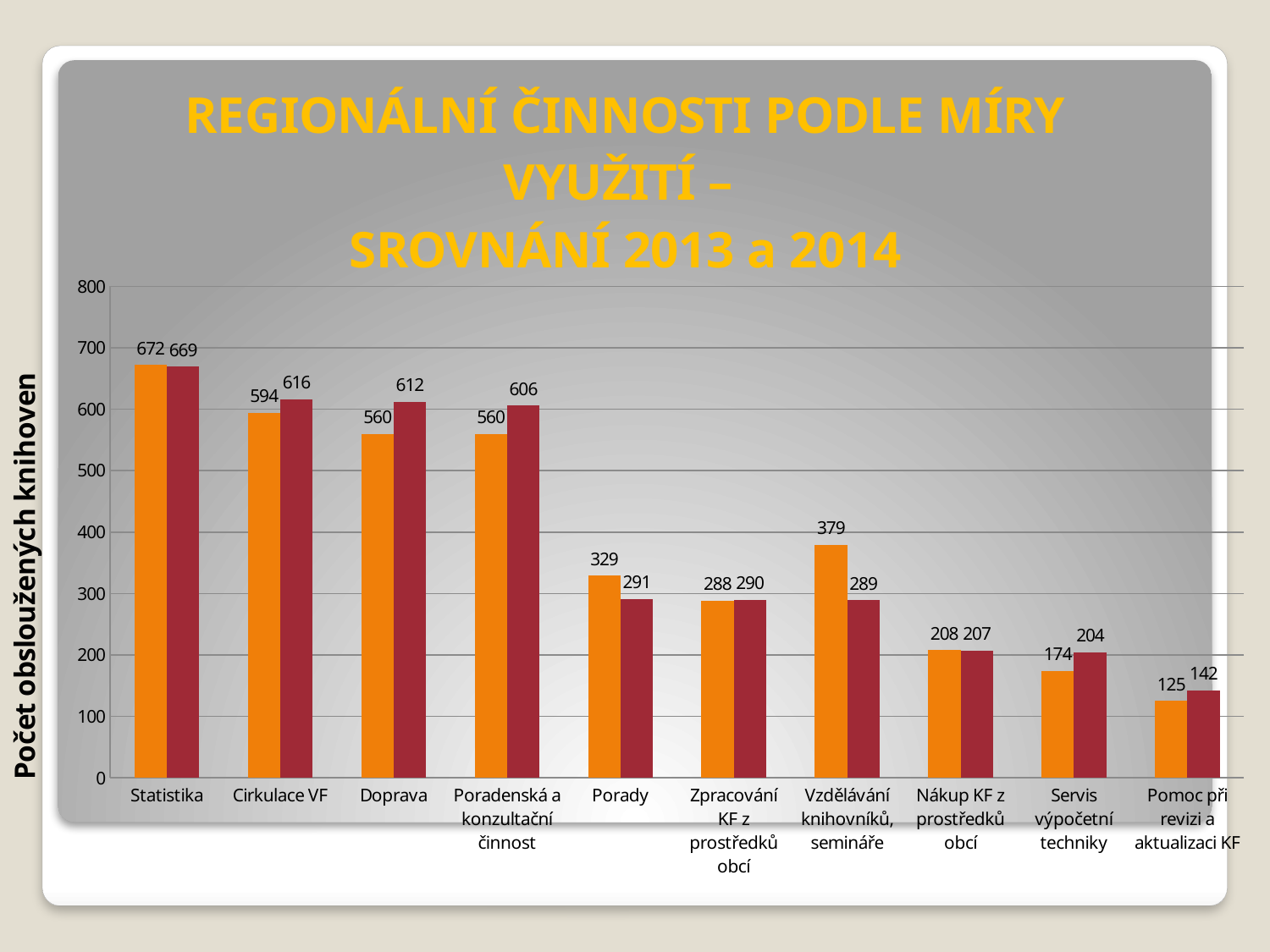
What is the value of the dark red bar for Doprava? 612 What is the difference between the orange and dark red bars for Vzdělávání knihovníků, semináře? 90 What type of chart is shown on the slide? bar chart What is the value of the orange bar for Statistika? 672 What is the value of the dark red bar for Pomoc při revizi a aktualizaci KF? 142 Which category has the lowest dark red bar? Pomoc při revizi a aktualizaci KF What is the value of the orange bar for Vzdělávání knihovníků, semináře? 379 How many categories are shown on the x axis of the chart? 10 For Servis výpočetní techniky, which bar is larger, the orange or the dark red one? dark red What is the difference between the orange bars for Porady and Nákup KF z prostředků obcí? 121 What is the label of the vertical axis? Počet obsloužených knihoven Which category has the highest orange bar? Statistika